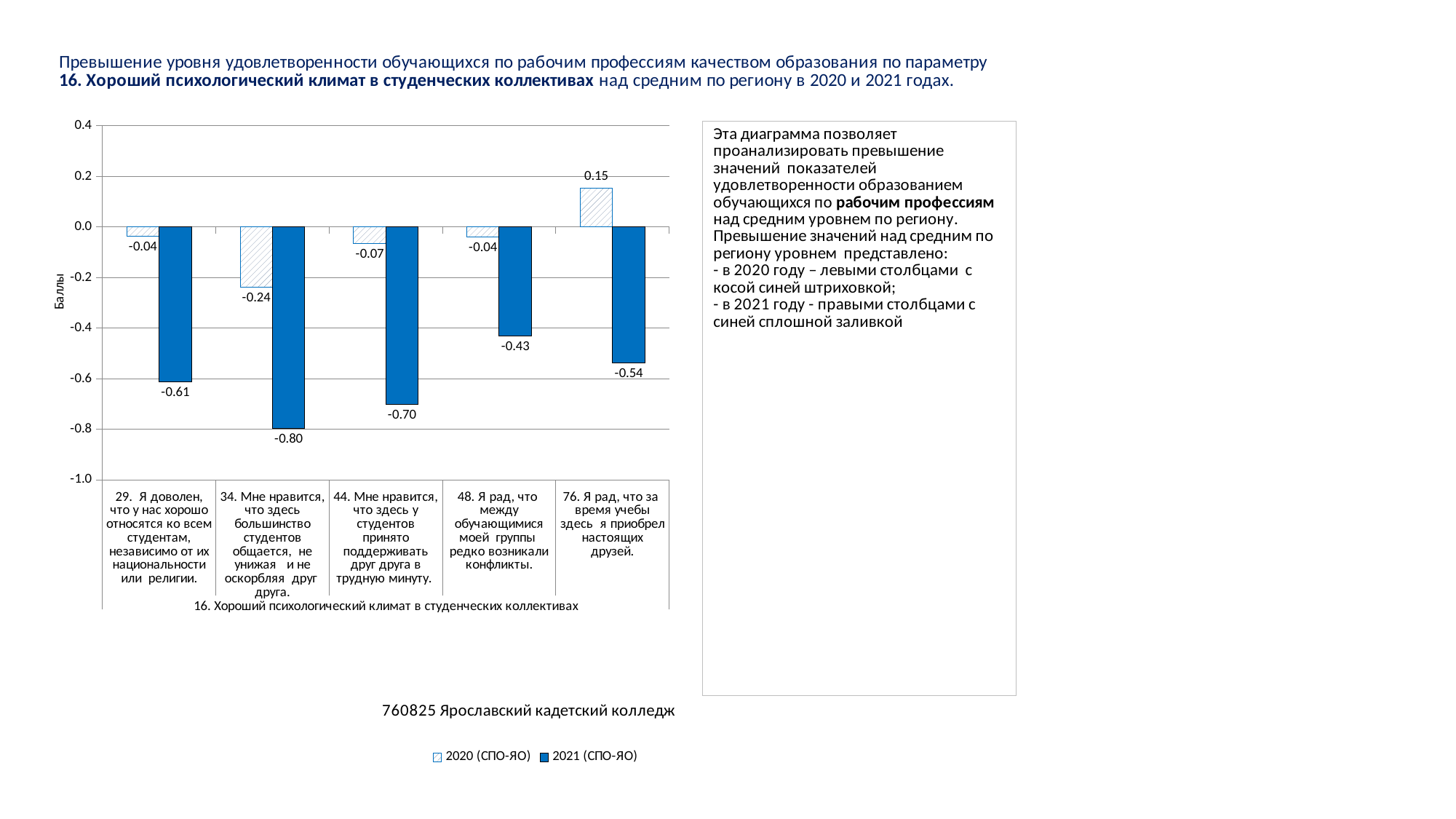
How many categories are shown on the x axis of the chart? 5 Is the 2021 (СПО-ЯО) value for category 44 greater or less than -0.6? less What kind of chart is shown on the slide? bar chart What is the 2020 (СПО-ЯО) value for category 76 (Я рад, что за время учебы здесь я приобрел настоящих друзей)? 0.15 Which category has the lowest 2021 (СПО-ЯО) value? 34. Мне нравится, что здесь большинство студентов общается, не унижая и не оскорбляя друг друга. What is the difference between the 2020 and 2021 (СПО-ЯО) values for category 29 (Я доволен, что у нас хорошо относятся ко всем студентам)? 0.57 Which is larger, the 2021 (СПО-ЯО) value for category 44 or for category 76? 76 (-0.54) What is the 2021 (СПО-ЯО) value for category 48 (Я рад, что между обучающимися моей группы редко возникали конфликты)? -0.43 How many series does the legend list? 2 What is the 2020 (СПО-ЯО) value for category 34 (Мне нравится, что здесь большинство студентов общается, не унижая и не оскорбляя друг друга)? -0.24 Which category has the highest 2020 (СПО-ЯО) value? 76. Я рад, что за время учебы здесь я приобрел настоящих друзей. What is the label of the vertical axis of the chart? Баллы